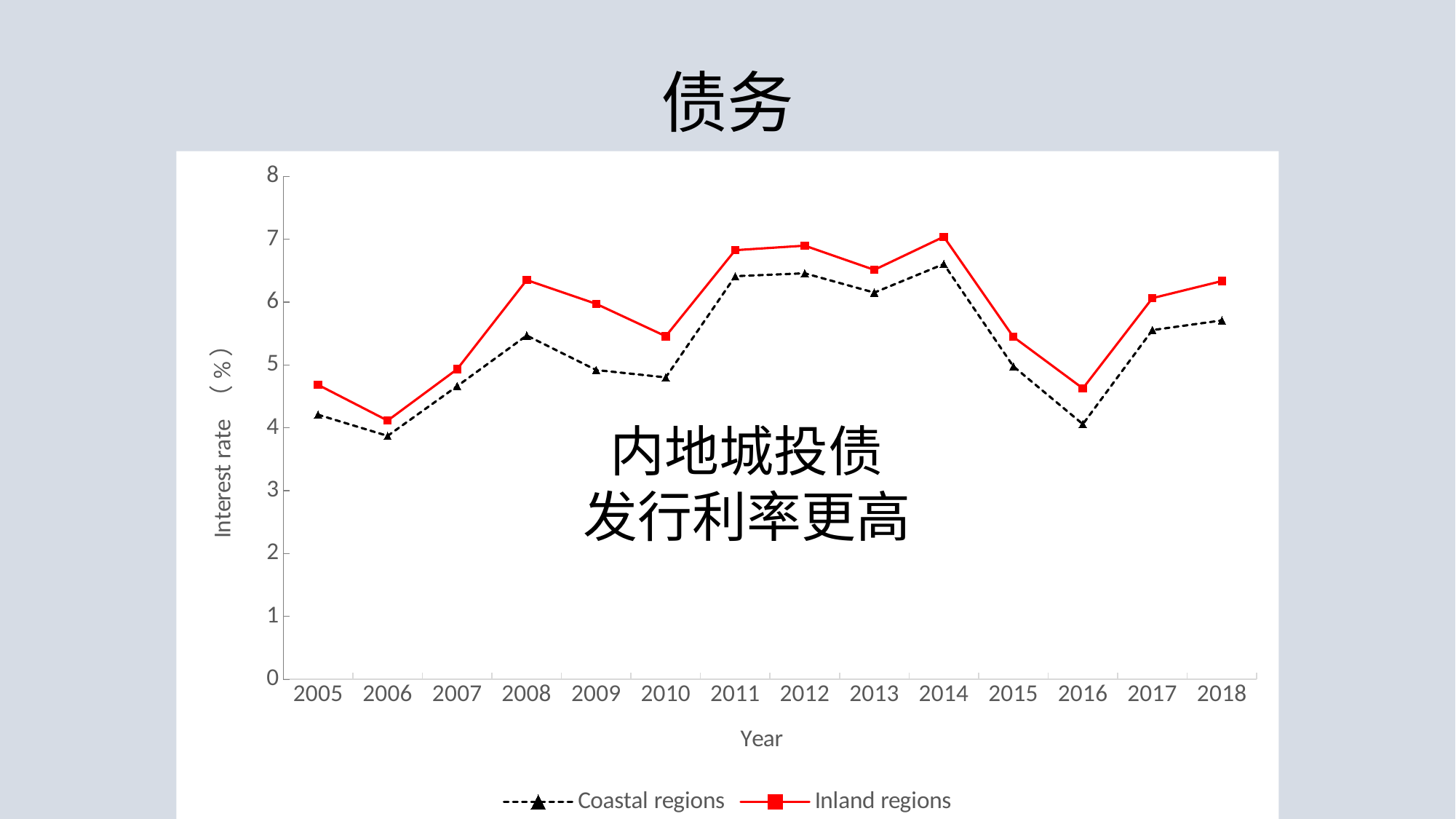
In which year does the Inland regions series reach its highest value? 2014 In which year does the Inland regions series reach its lowest value? 2006 In 2010, which series has the larger value, Coastal regions or Inland regions? Inland regions How many series does the legend list? 2 How many years are plotted along the x axis? 14 Is the value for Inland regions in 2016 greater or less than 5? less Do the values for Inland regions rise or fall from 2014 to 2016? Fall What kind of chart is shown on the slide? Line chart Is the value for Coastal regions in 2006 greater or less than 4? less What is the label on the x axis? Year Is the value for Coastal regions in 2008 greater or less than 5? greater